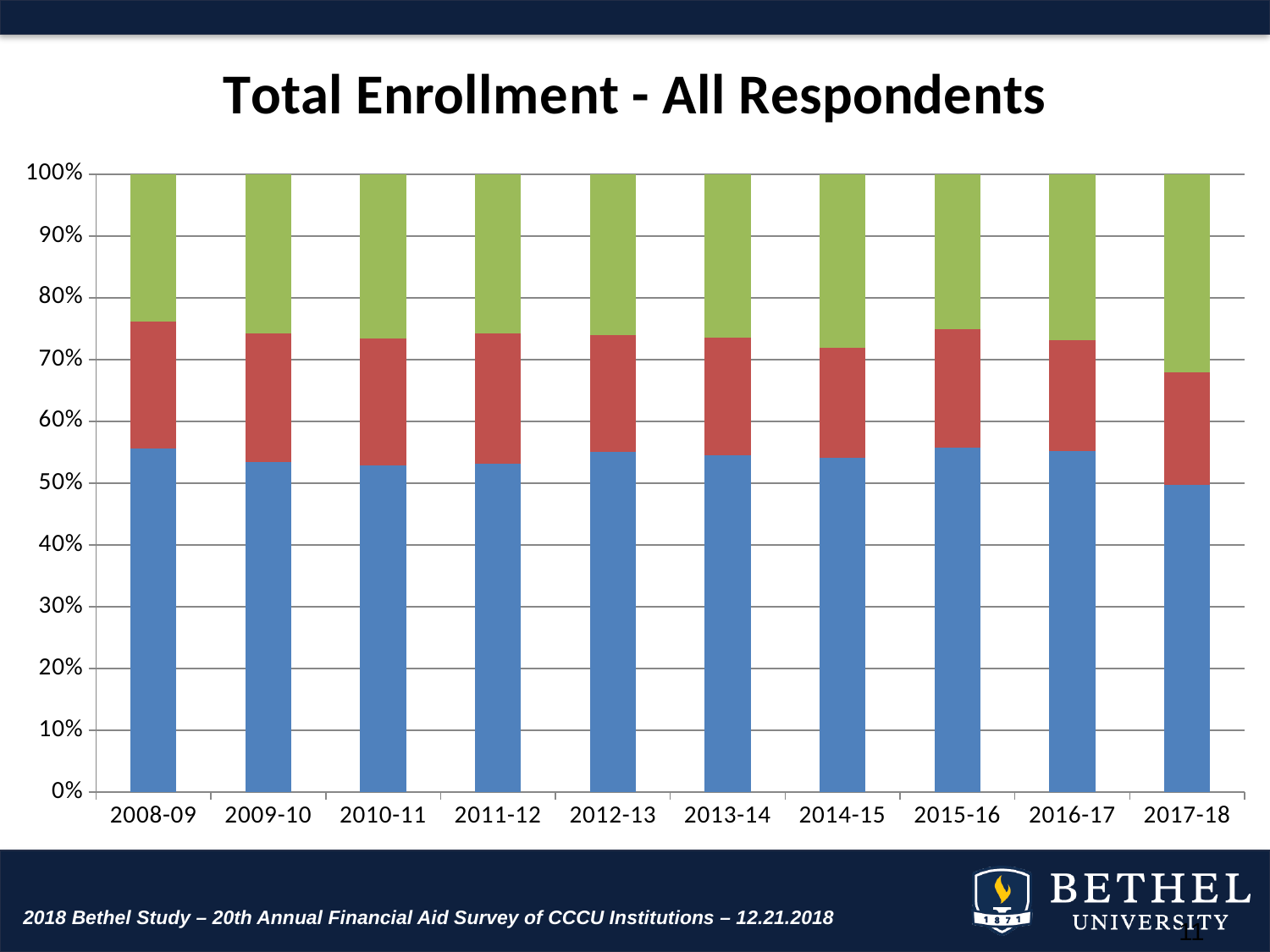
Which colour segment sits at the bottom of each stacked bar? Blue Which year has the larger blue segment, 2008-09 or 2017-18? 2008-09 Is the top of the red segment for 2015-16 greater or less than 70%? greater What is the total height of the 2017-18 stacked bar? 100% What kind of chart is shown on the slide? Stacked bar chart What is the title of the chart? Total Enrollment - All Respondents Which year has the largest green segment? 2017-18 How many academic years are shown on the x axis of the chart? 10 Is the top of the red segment for 2017-18 greater or less than 70%? less Which year has the smallest blue segment? 2017-18 Is the blue segment for 2008-09 greater or less than 50%? greater How many coloured segments make up each bar in the chart? 3